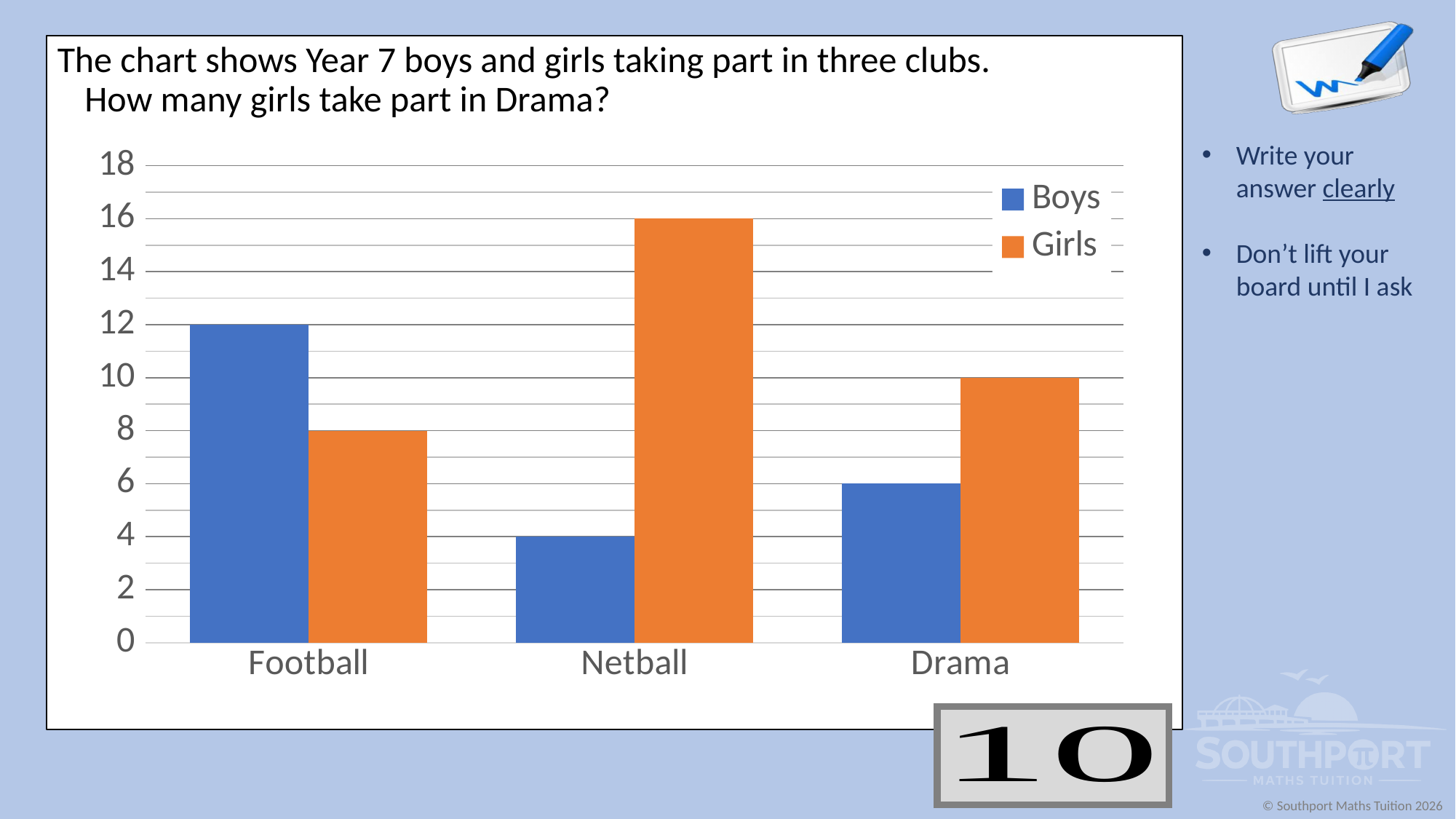
How many girls take part in Netball? 16 How many more girls than boys take part in Netball? 12 Which colour represents Girls in the chart? Orange How many series does the legend list? 2 How many girls take part in Drama? 10 Which club has the fewest boys taking part? Netball How many boys take part in Football? 12 Which club has the most girls taking part? Netball Are there more boys or girls taking part in Football? Boys How many clubs are shown on the chart? 3 What kind of chart is shown on the slide? Bar chart How many boys take part in Netball? 4